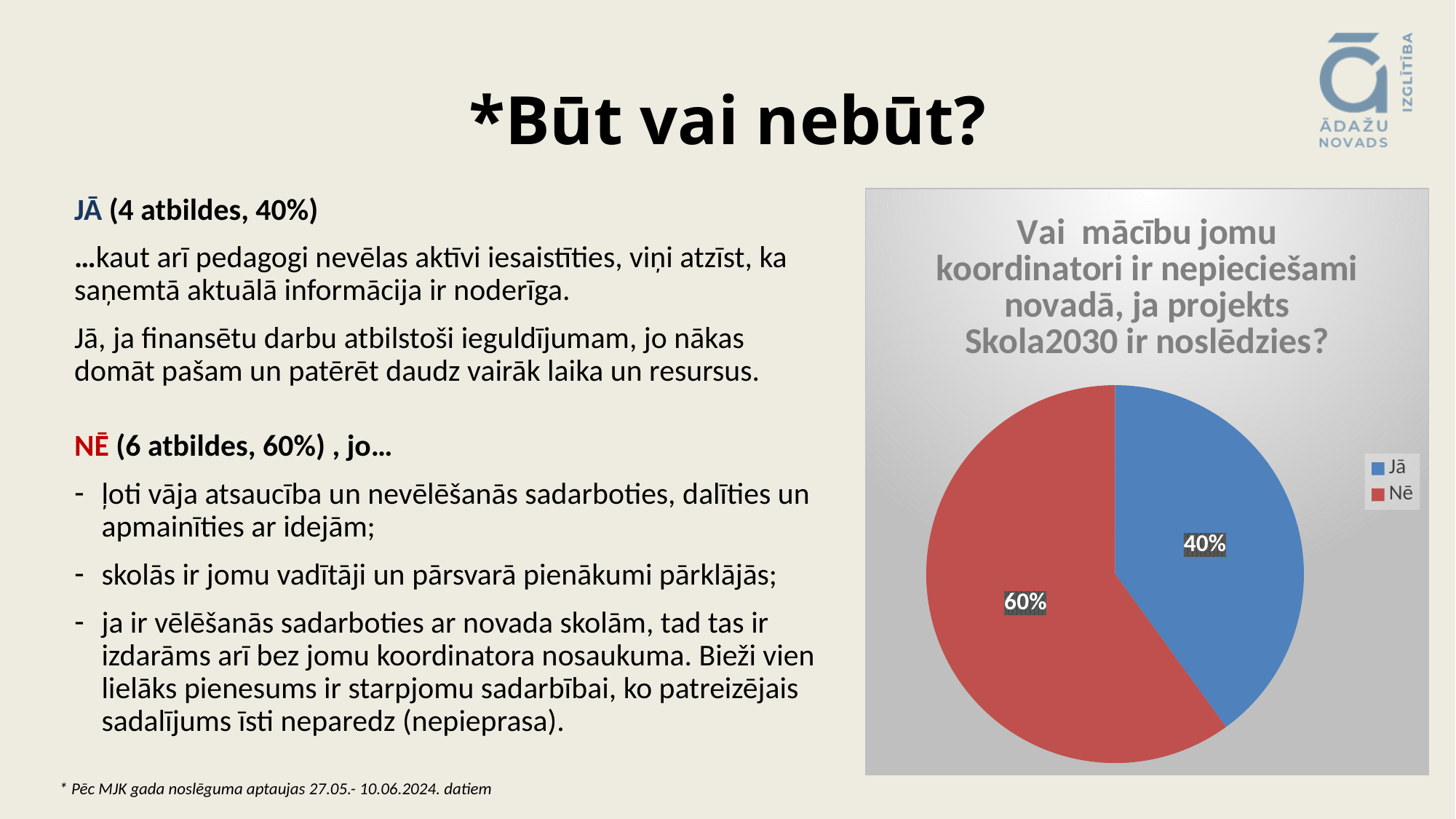
Which is larger, the share for "Jā" or the share for "Nē"? Nē What kind of chart is shown on the slide? pie chart How many entries does the chart legend list? 2 What colour is the "Nē" slice of the pie? red How many slices does the pie chart have? 2 What share of the pie does "Nē" have? 60% What is the difference in percentage points between the "Nē" share and the "Jā" share? 20% Which slice of the pie is the smallest? Jā What share of the pie does "Jā" have? 40% What is the title of the pie chart? Vai mācību jomu koordinatori ir nepieciešami novadā, ja projekts Skola2030 ir noslēdzies? Which slice of the pie is the largest? Nē